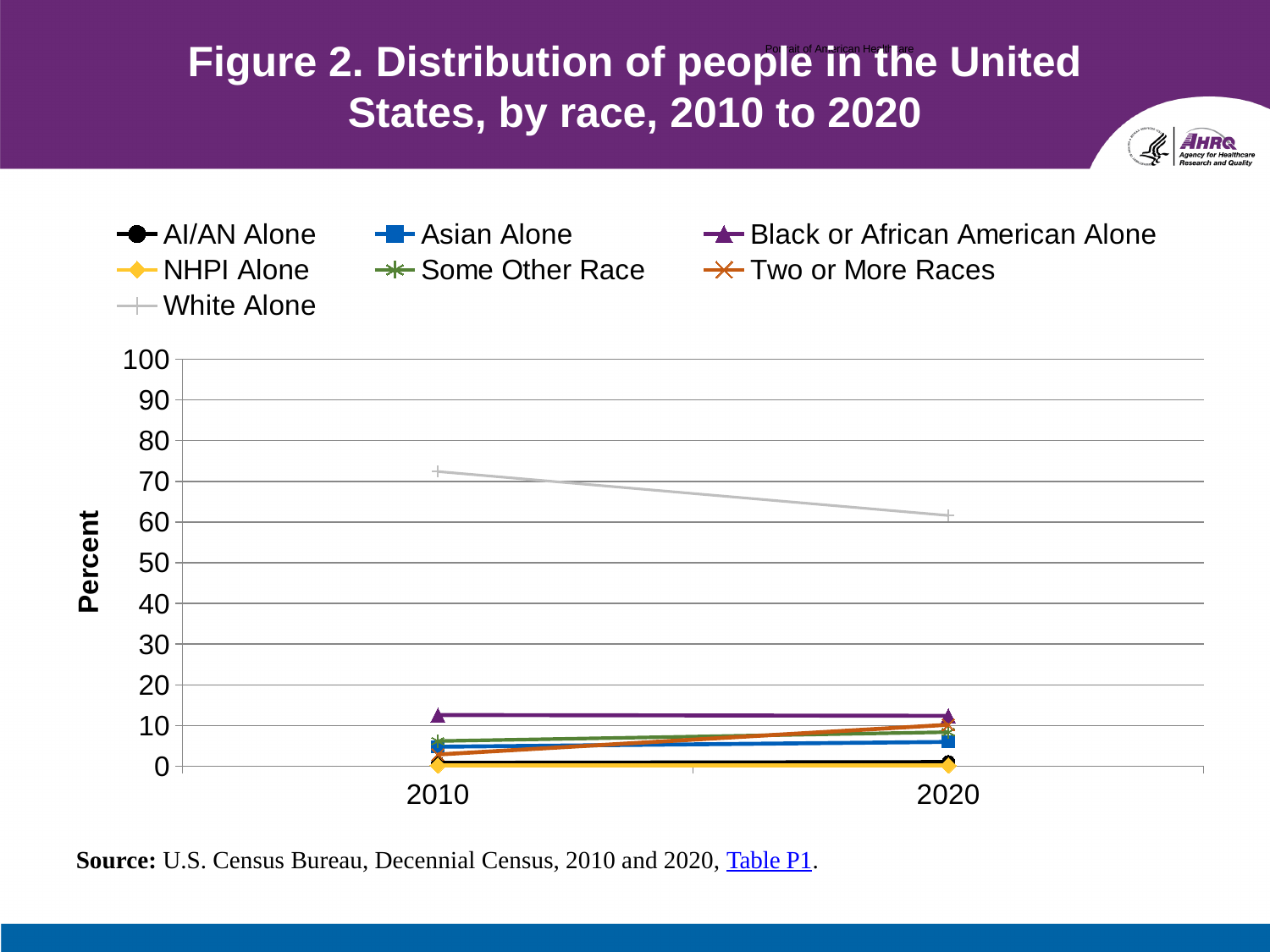
Which is larger in 2020: the value for White Alone or the value for Black or African American Alone? White Alone Does the value for White Alone rise or fall from 2010 to 2020? fall What kind of chart is shown on the slide? line chart Which series has the highest value in 2010? White Alone What is the label on the y axis? Percent How many series does the legend list? 7 Is the value for White Alone in 2020 greater or less than 70? less How many years are shown on the x axis? 2 Is the value for Black or African American Alone in 2010 greater or less than 20? less Does the value for Two or More Races rise or fall from 2010 to 2020? rise Which series has the highest value in 2020? White Alone Which is larger for Two or More Races: the value in 2010 or the value in 2020? 2020